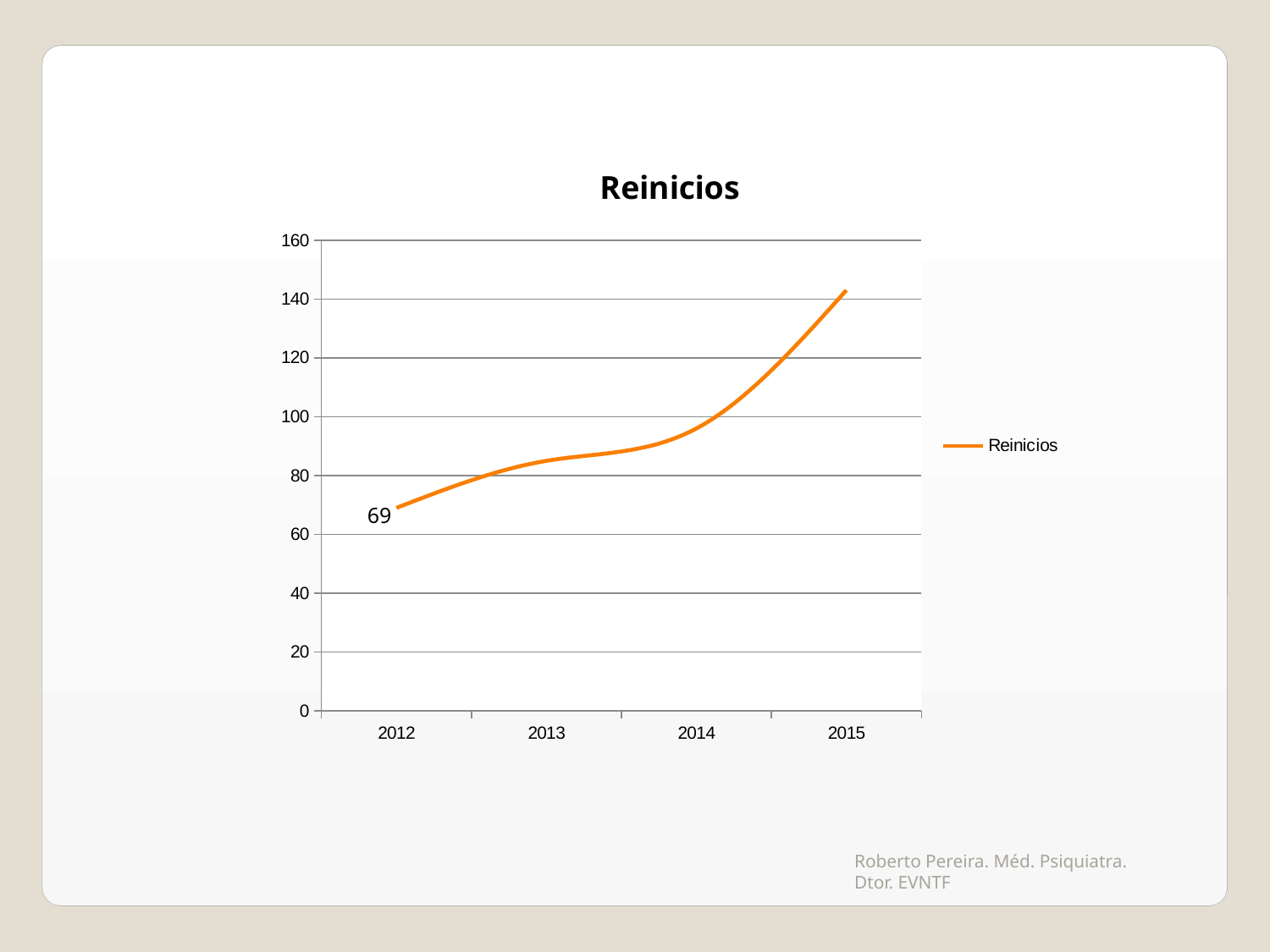
Which year has the highest value in the Reinicios chart? 2015 Is the value for 2013 greater or less than 80? greater What is the title of the chart? Reinicios Which year has the lowest value in the Reinicios chart? 2012 How many years are plotted on the x axis of the chart? 4 How many series does the legend list? 1 What kind of chart is shown on the slide? line chart Is the value for 2014 greater or less than 100? less Which is larger, the value for 2015 or the value for 2012? 2015 Do the values rise or fall from 2012 to 2015? rise What is the value for 2012 in the Reinicios chart? 69 Is the value for 2015 greater or less than 120? greater